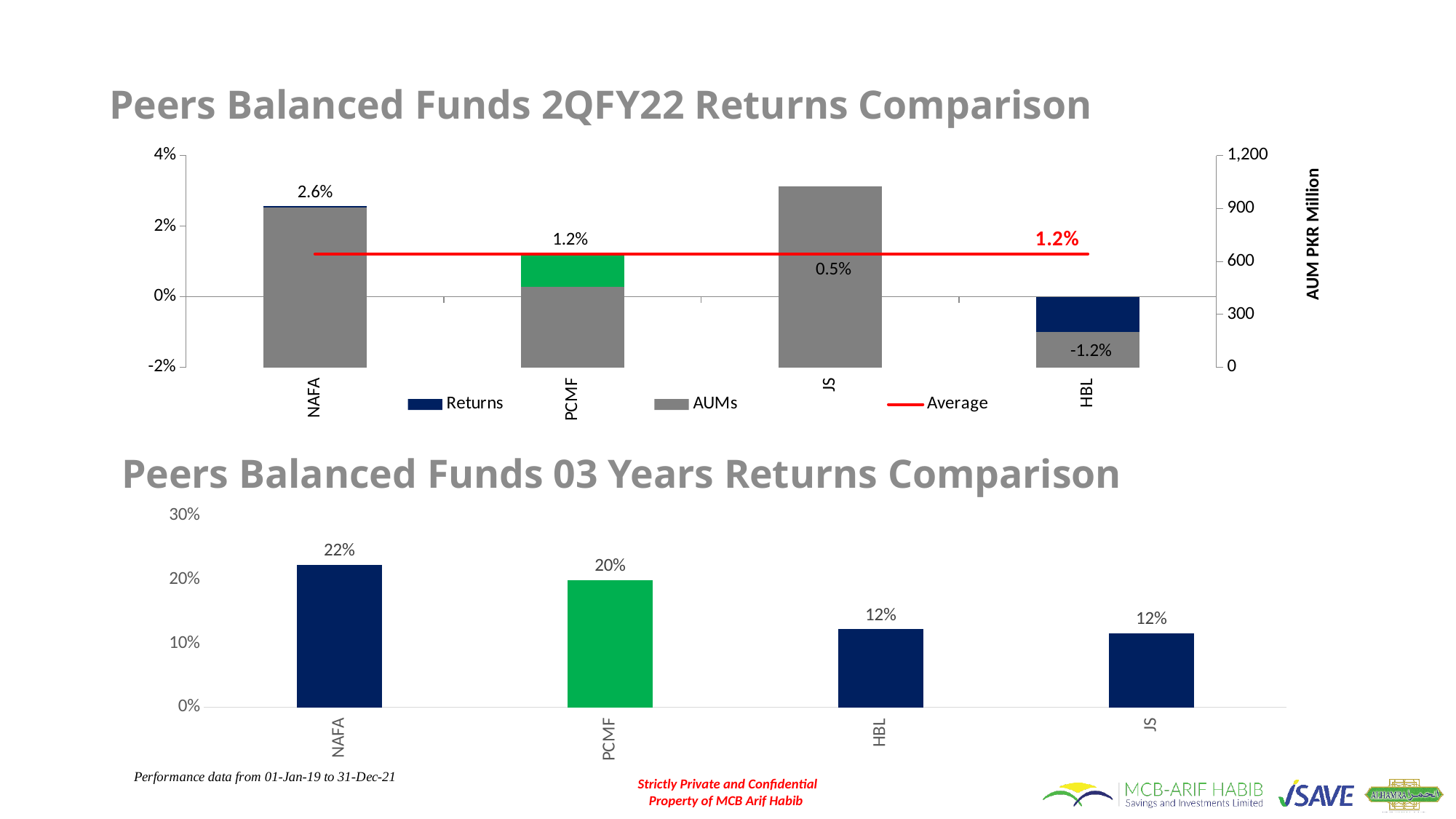
How many series does the legend of the 2QFY22 Returns Comparison chart list? 3 In the 03 Years Returns Comparison chart, what is the difference between the returns of NAFA and HBL? 10% In the 03 Years Returns Comparison chart, which fund has the highest return? NAFA In the 2QFY22 Returns Comparison chart, what is the return for HBL? -1.2% How many funds are shown in the 03 Years Returns Comparison chart? 4 In the 03 Years Returns Comparison chart, what is the return for PCMF? 20% In the 2QFY22 Returns Comparison chart, is the AUM for JS greater or less than 900? greater In the 2QFY22 Returns Comparison chart, what is the difference between the returns of NAFA and JS? 2.1% In the 2QFY22 Returns Comparison chart, what is the return for NAFA? 2.6% In the 2QFY22 Returns Comparison chart, is the AUM for HBL greater or less than 300? less In the 2QFY22 Returns Comparison chart, which fund has the highest return? NAFA In the 2QFY22 Returns Comparison chart, what is the value of the Average line? 1.2%